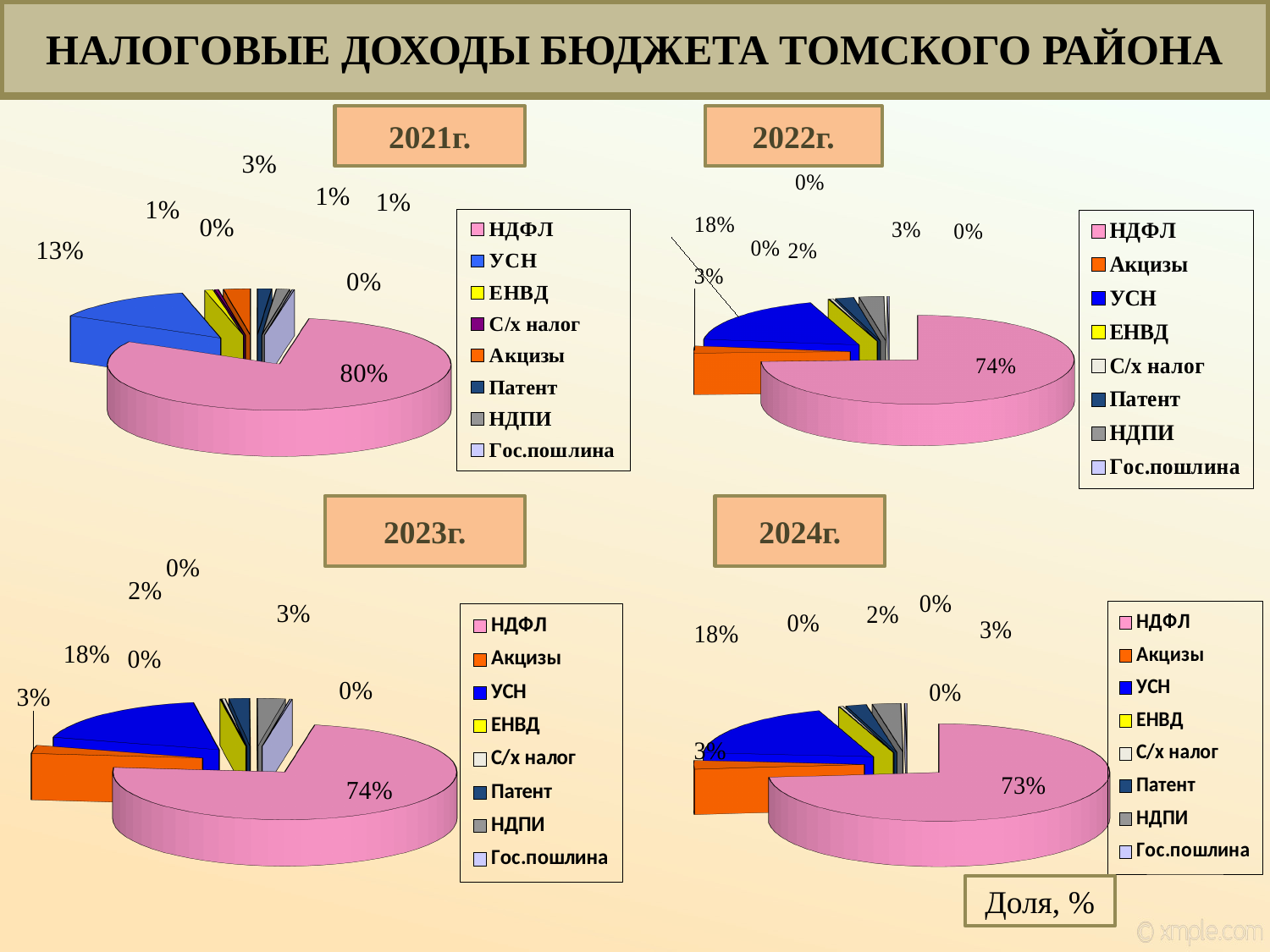
In the 2021г. chart, which category has the largest share? НДФЛ In the 2023г. chart, what share does УСН have? 18% In the 2024г. chart, what share does Акцизы have? 3% In the 2023г. chart, which is larger, the share of УСН or the share of Акцизы? УСН In the 2022г. chart, what share does НДФЛ have? 74% In the 2024г. chart, what share does НДФЛ have? 73% How many entries does the legend of the 2022г. chart list? 8 What kind of chart is used for the 2021г. data? pie chart What is the difference between the НДФЛ share in the 2021г. chart and the НДФЛ share in the 2024г. chart? 7% In the 2021г. chart, what share does НДФЛ have? 80% How many pie charts are shown on the slide? 4 In the 2021г. chart, what share does УСН have? 13%